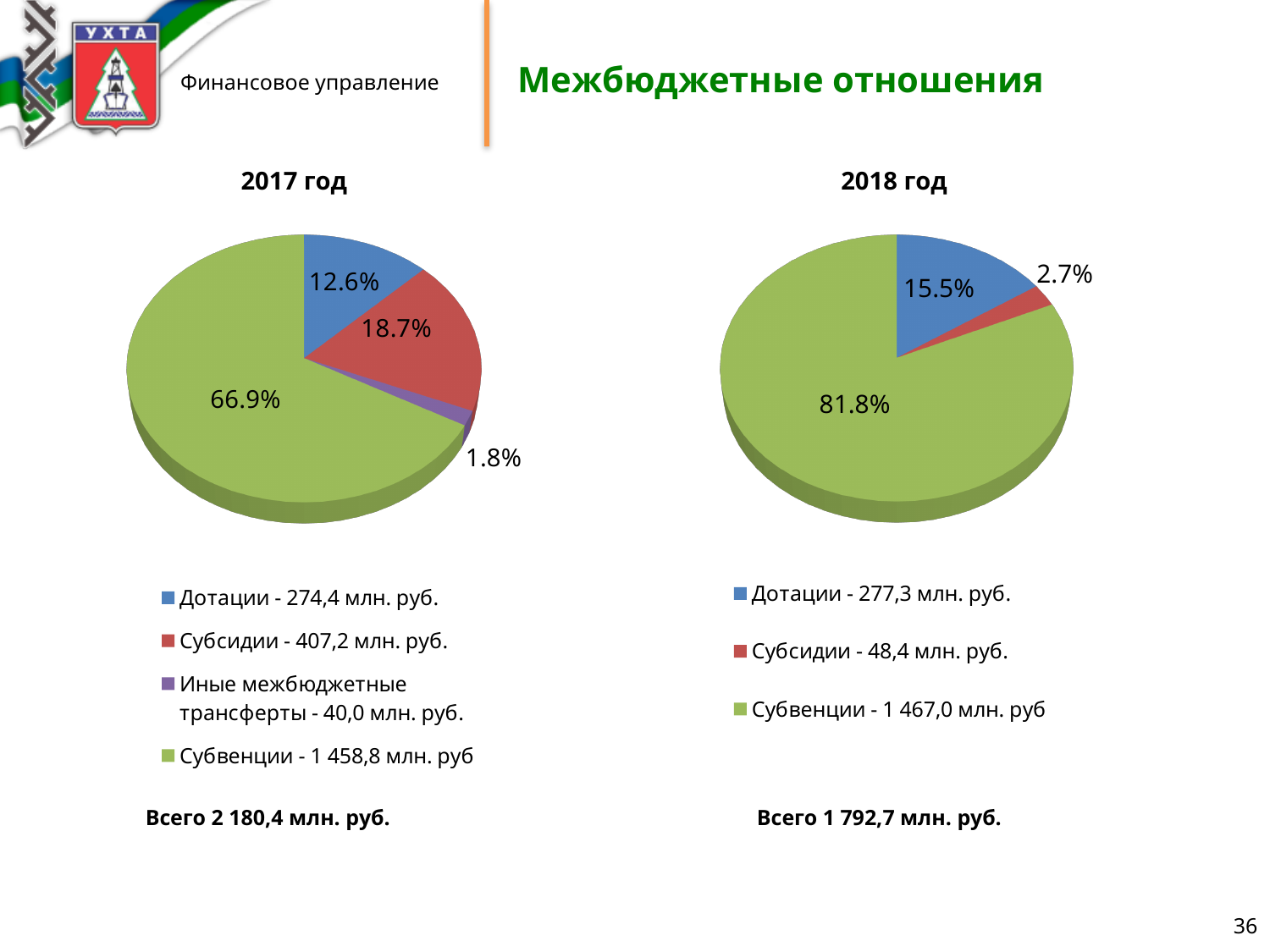
In the "2017 год" chart, which category has the smallest share? Иные межбюджетные трансферты In the "2017 год" chart, what is the difference between the Субсидии share and the Дотации share? 6.1% What kind of chart is used for the "2017 год" chart? pie chart What is the difference between the Субвенции share in the "2018 год" chart and the Субвенции share in the "2017 год" chart? 14.9% How many slices does the "2017 год" pie chart have? 4 In the "2018 год" chart, which category has the largest share? Субвенции In the "2017 год" chart, what share does Субсидии have? 18.7% How many slices does the "2018 год" pie chart have? 3 In the "2018 год" chart, which is larger: the share of Дотации or the share of Субсидии? Дотации In the "2018 год" chart, what colour is the Субвенции slice? green In the "2018 год" chart, what share does Дотации have? 15.5% In the "2017 год" chart, what share does Субвенции have? 66.9%